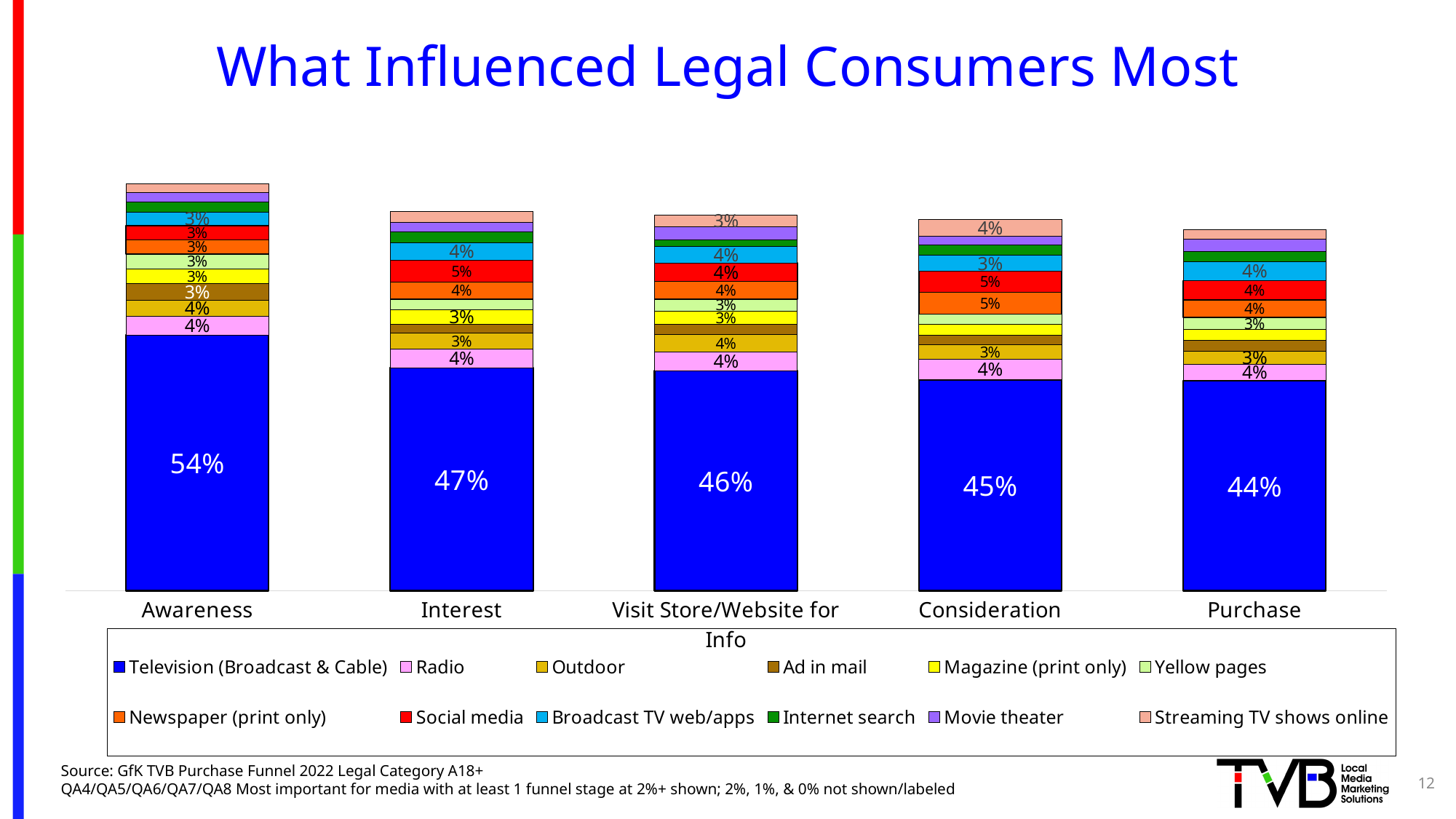
Which funnel stage has the highest Television (Broadcast & Cable) value? Awareness What is the Newspaper (print only) value for Consideration? 5% Which funnel stage has the lowest Television (Broadcast & Cable) value? Purchase Do the Television (Broadcast & Cable) values rise or fall from Awareness to Purchase? Fall How many series does the legend list? 12 What is the difference between the Television (Broadcast & Cable) values for Awareness and Purchase? 10 percentage points What is the Television (Broadcast & Cable) value for Awareness? 54% How many funnel stages (categories) are shown along the x axis? 5 What kind of chart is shown on the slide? Stacked bar chart What is the Television (Broadcast & Cable) value for Purchase? 44% What is the title of the chart? What Influenced Legal Consumers Most What is the Social media value for Interest? 5%